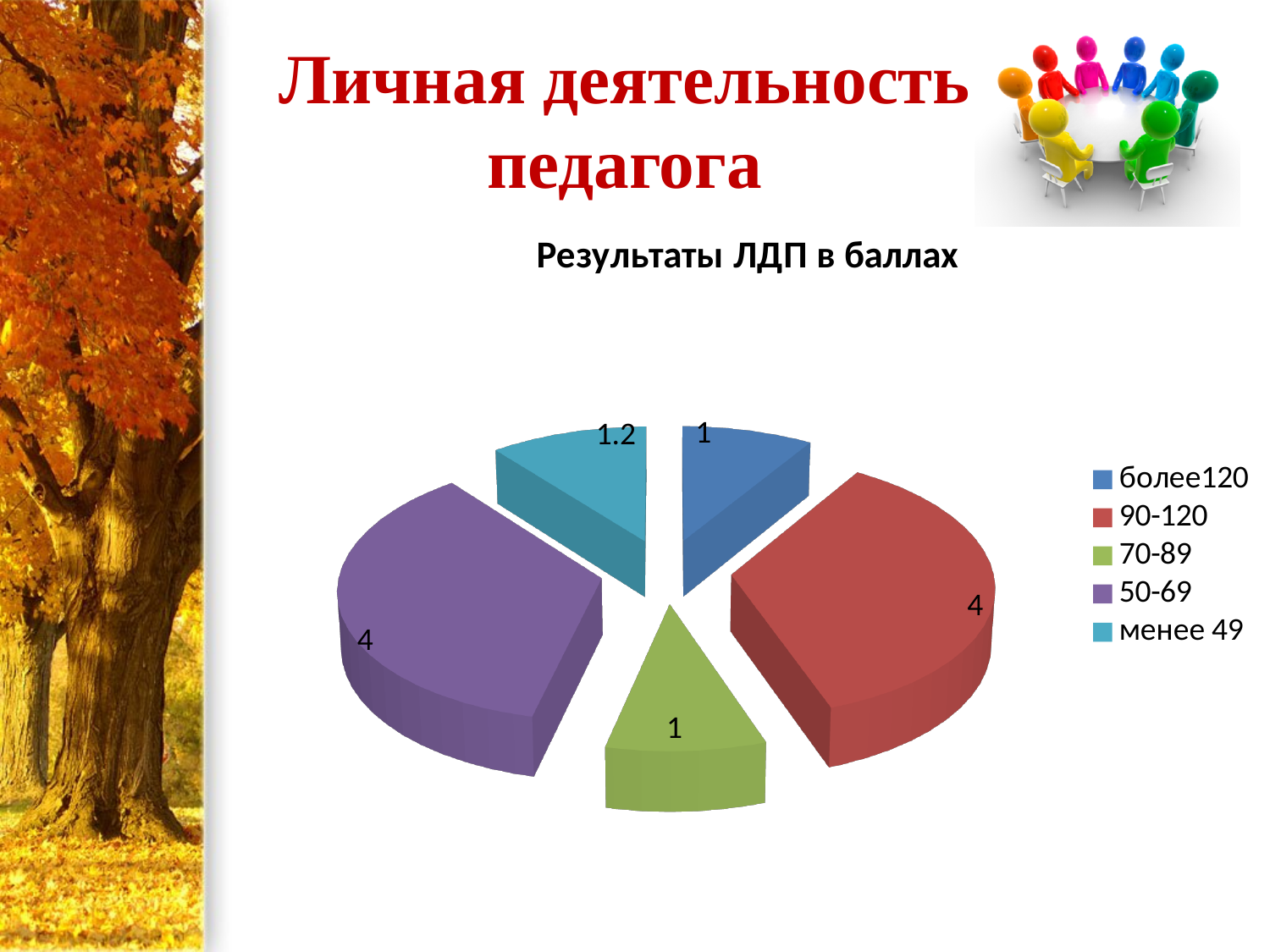
What is the difference between the value for 90-120 and the value for 70-89? 3 What is the value shown for the 90-120 slice? 4 What kind of chart is shown on the slide? Pie chart Which is larger, the value for менее 49 or the value for 70-89? менее 49 What is the value shown for the менее 49 slice? 1.2 How many slices does the pie chart have? 5 Which is larger, the value for 90-120 or the value for более120? 90-120 What is the value shown for the 70-89 slice? 1 What is the value shown for the 50-69 slice? 4 What is the value shown for the более120 slice? 1 What is the difference between the value for 50-69 and the value for менее 49? 2.8 What is the title of the chart? Результаты ЛДП в баллах